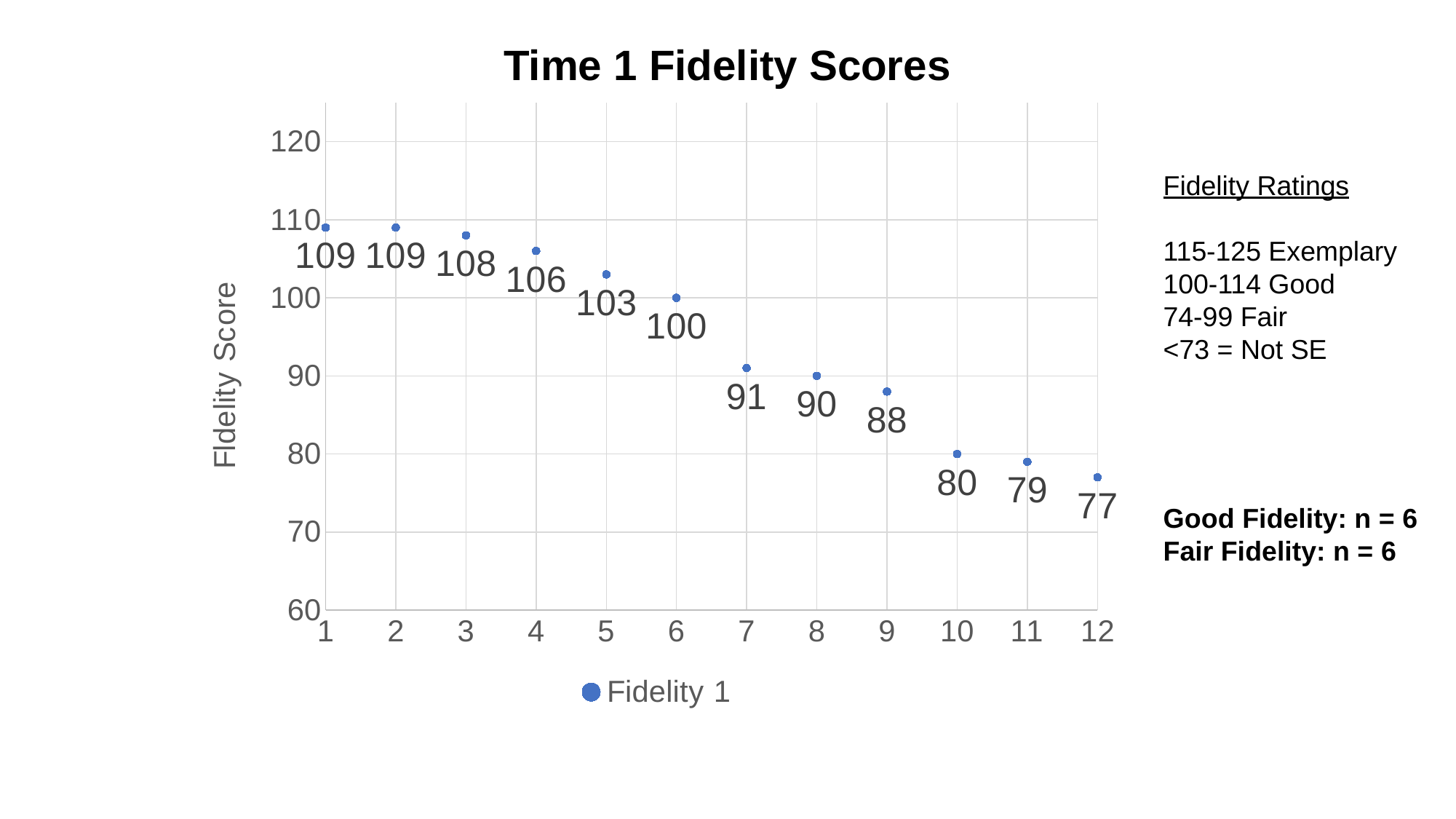
Which has a higher fidelity score, point 3 or point 8? Point 3 Which point has the lowest fidelity score? 12 How many data points are plotted in the chart? 12 What is the fidelity score for point 12? 77 How many series does the legend list? 1 What is the difference between the fidelity scores for point 6 and point 7? 9 What is the difference between the fidelity scores for point 1 and point 12? 32 What kind of chart is shown on the slide? Scatter chart Do the fidelity scores rise or fall from point 1 to point 12? Fall What is the fidelity score for point 4? 106 Is the fidelity score for point 10 greater or less than 90? less What is the fidelity score for point 9? 88